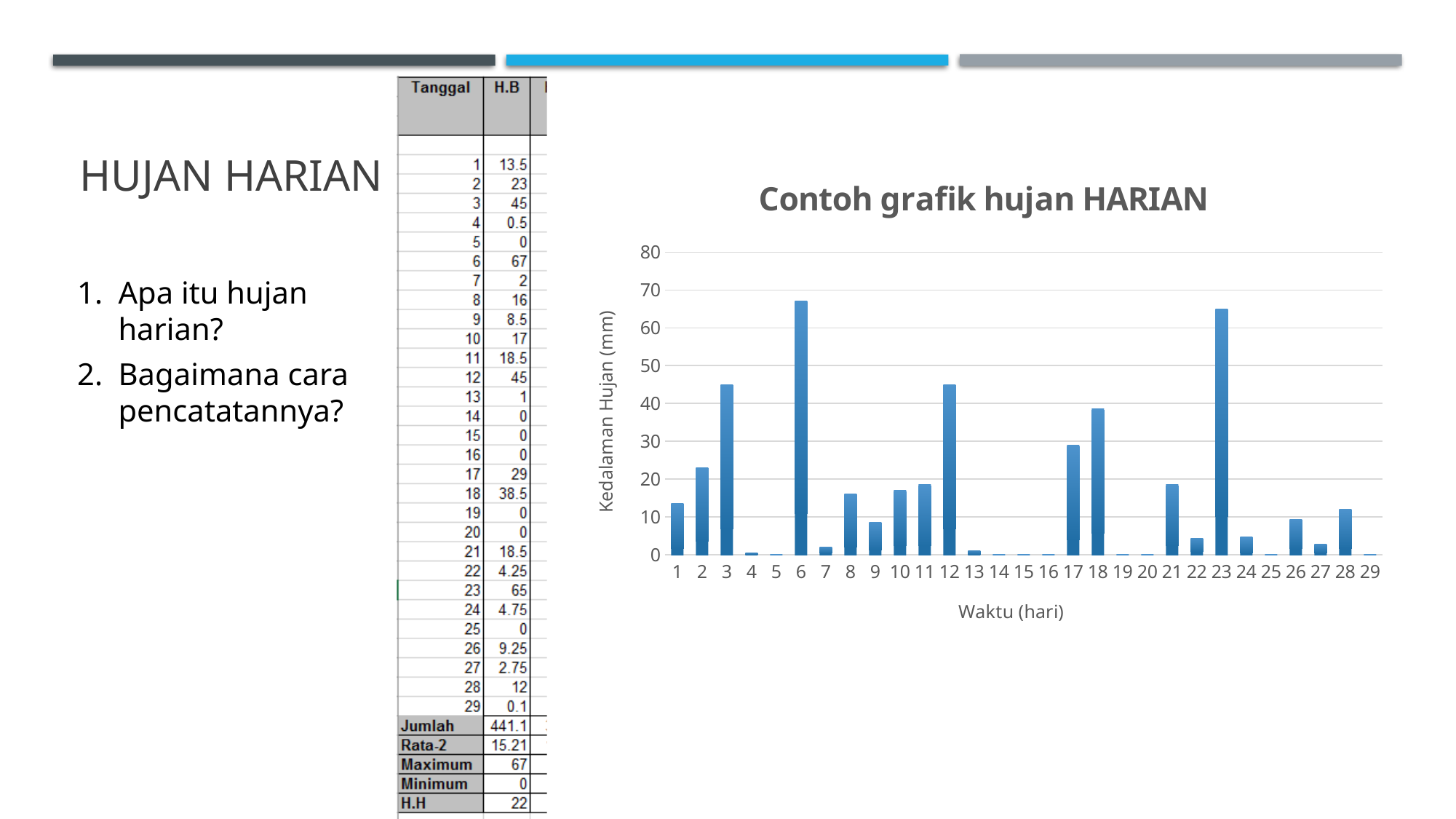
What is the label of the x axis of the chart? Waktu (hari) What is the value for day 14 in the chart? 0 How many days (categories) are plotted on the x axis of the chart? 29 Which has the larger value, day 17 or day 2? day 17 Is the value for day 17 greater or less than 30? less Is the value for day 6 greater or less than 60? greater What is the label of the y axis of the chart? Kedalaman Hujan (mm) Is the value for day 9 greater or less than 10? less Which has the larger value, day 3 or day 18? day 3 What kind of chart is shown under the title "Contoh grafik hujan HARIAN"? bar chart